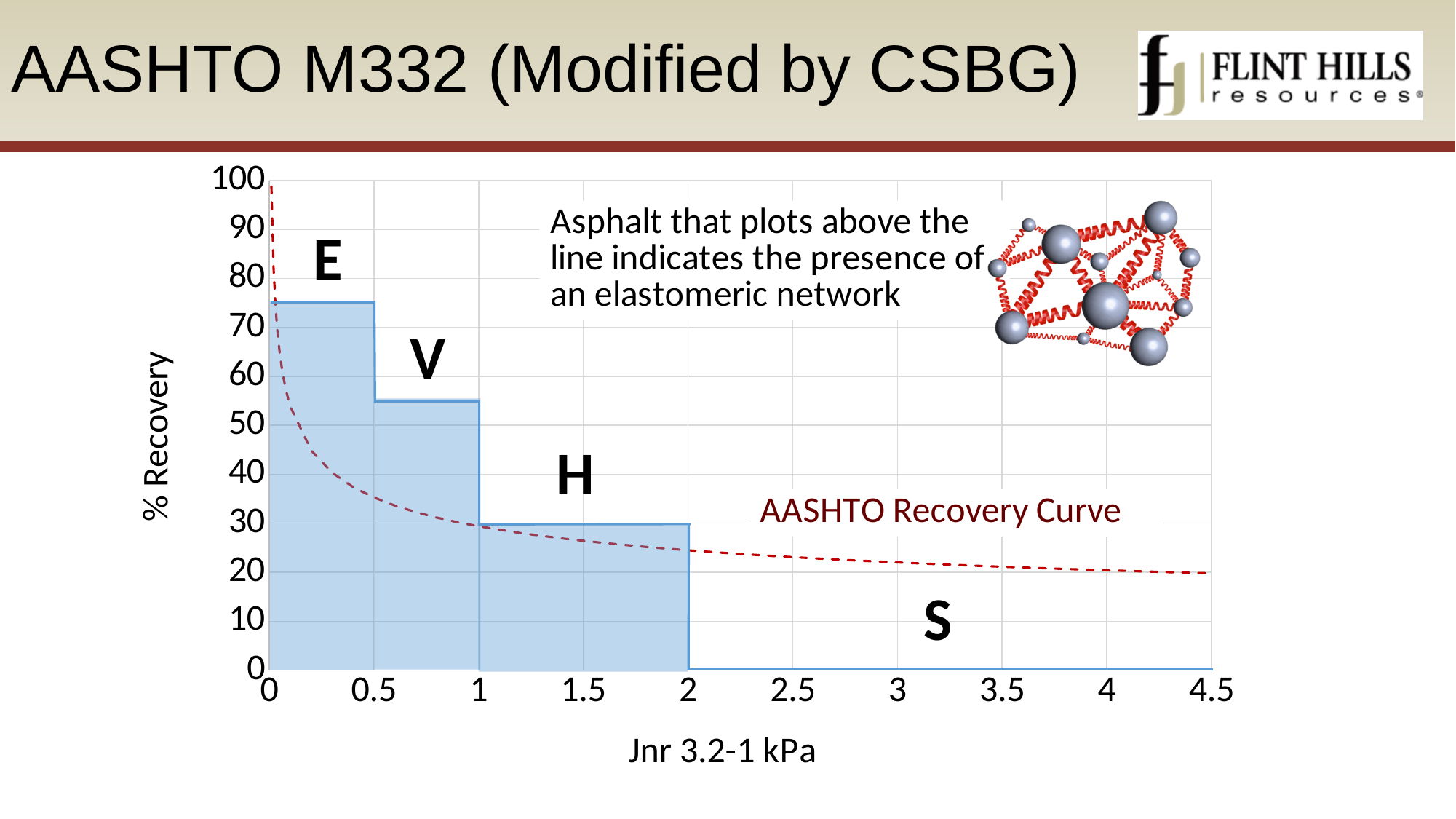
Which has a higher % Recovery boundary, the E region or the V region? E Is the % Recovery boundary for the V region greater or less than 60? less What is the label of the x axis? Jnr 3.2-1 kPa Does the dashed AASHTO Recovery Curve rise or fall as Jnr 3.2-1 kPa increases? fall How many labeled regions (letters) are shown on the chart? 4 What is the name given to the dashed red line on the chart? AASHTO Recovery Curve At what Jnr 3.2-1 kPa value does the shaded H region end? 2 Is the % Recovery boundary for the V region greater or less than 50? greater Is the % Recovery boundary for the E region greater or less than 70? greater Which labeled region (E, V, H or S) has the highest % Recovery boundary? E What is the % Recovery value of the shaded boundary in the S region? 0 What is the % Recovery value of the step boundary for the H region? 30